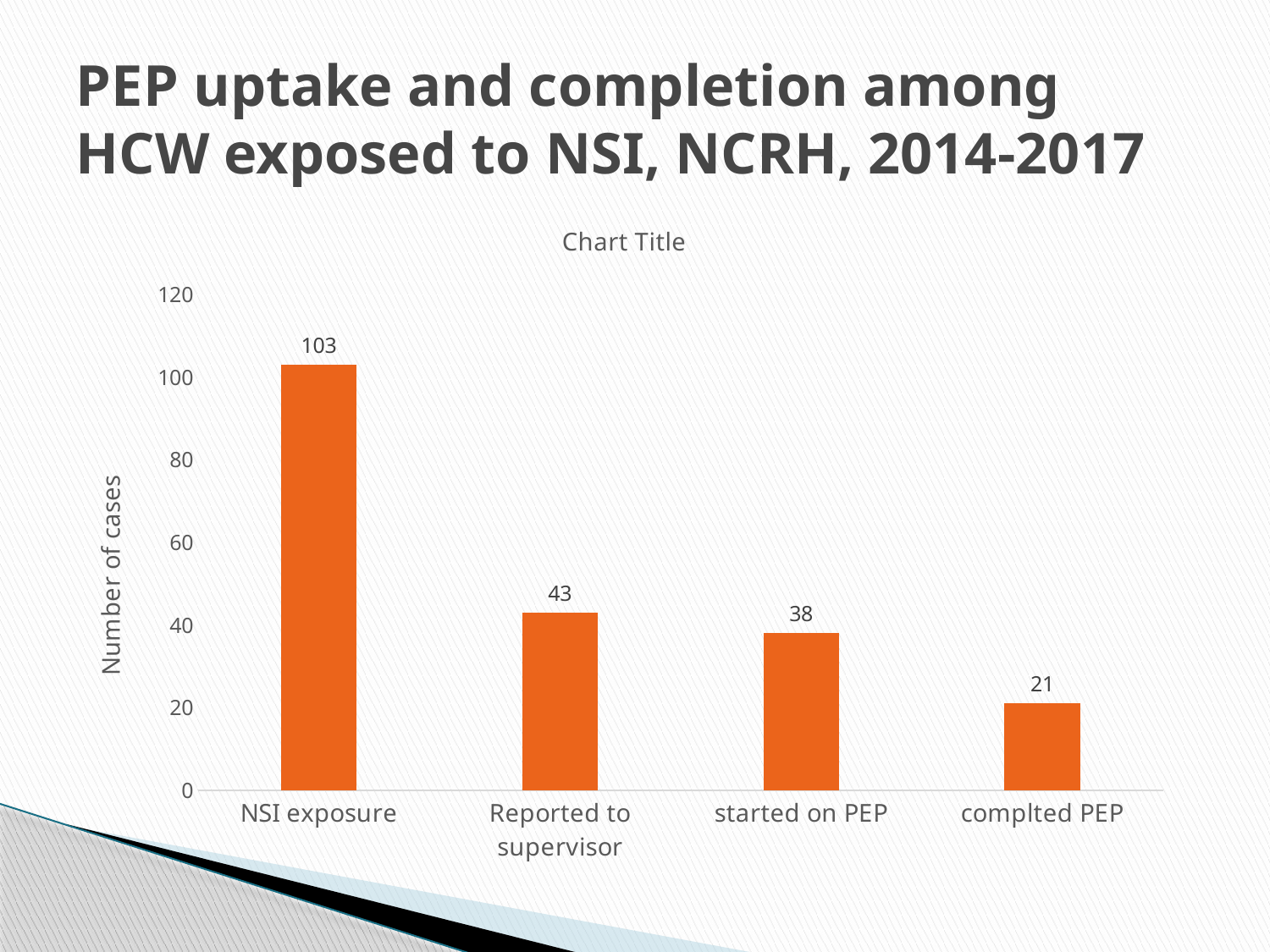
What kind of chart is shown on the slide? Bar chart What is the number of cases for Reported to supervisor? 43 How many categories are shown on the x axis? 4 Which is larger, the number of cases for Reported to supervisor or started on PEP? Reported to supervisor Which category has the lowest number of cases? complted PEP What is the number of cases for complted PEP? 21 Which category has the highest number of cases? NSI exposure What is the number of cases for started on PEP? 38 What is the difference between the number of cases for NSI exposure and Reported to supervisor? 60 What is the difference between the number of cases for started on PEP and complted PEP? 17 Do the values rise or fall from left to right along the x axis? Fall What is the number of cases for NSI exposure? 103